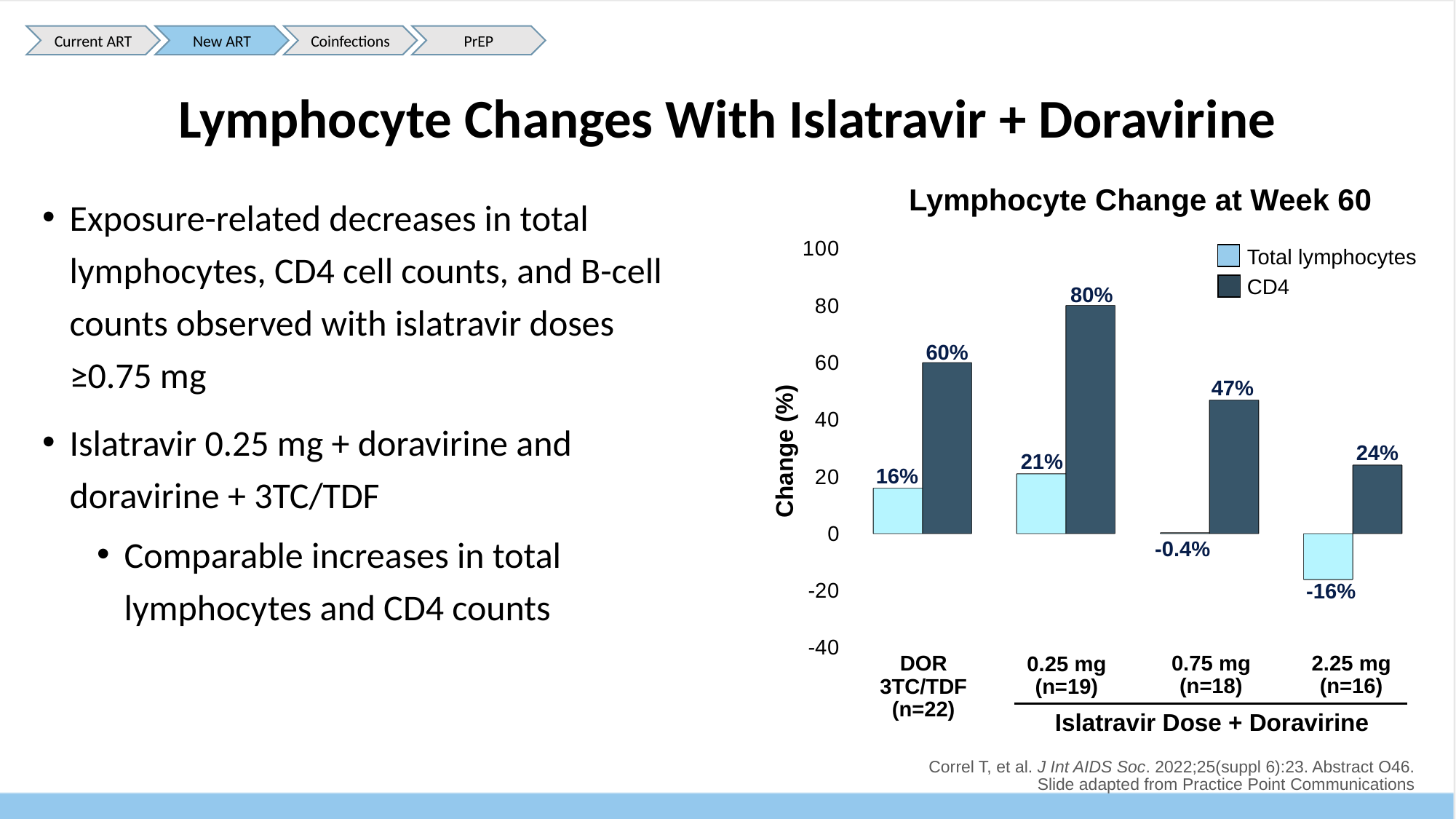
Which dose group has the highest CD4 change? 0.25 mg (n=19) Which group has the lowest total lymphocyte change? 2.25 mg (n=16) What is the total lymphocyte change for the 0.75 mg islatravir dose group? -0.4% What is the CD4 change for the 0.25 mg islatravir dose group? 80% What is the title of the chart? Lymphocyte Change at Week 60 What is the total lymphocyte change for the 2.25 mg islatravir dose group? -16% How many dose groups are shown on the x axis? 4 What kind of chart is shown? Bar chart What is the total lymphocyte change for the DOR 3TC/TDF group? 16% Is the CD4 change larger for the 0.75 mg group or the 2.25 mg group? 0.75 mg group How many series does the legend list? 2 What is the difference between the CD4 change and the total lymphocyte change in the DOR 3TC/TDF group? 44%